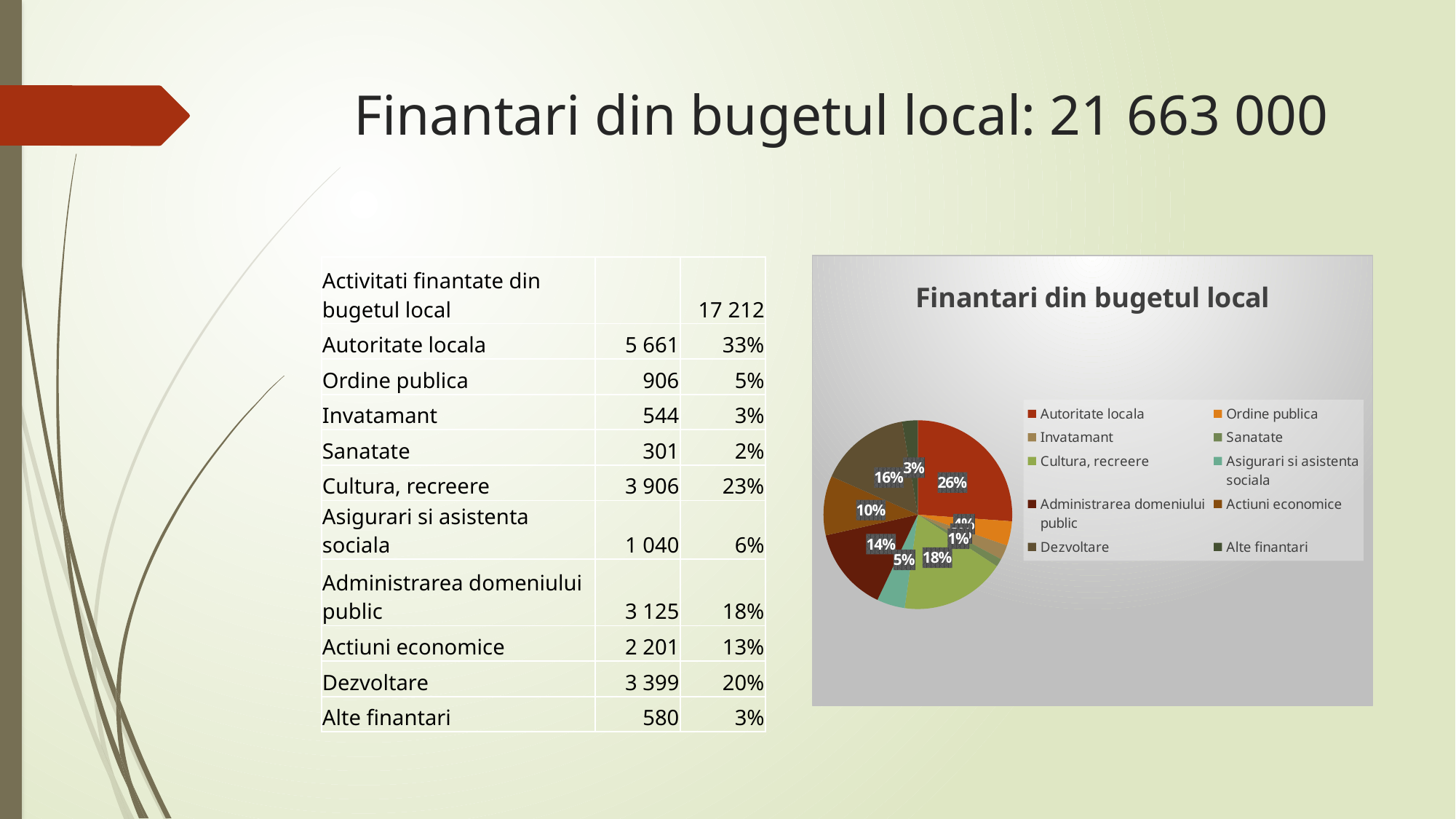
What share of the pie does Actiuni economice have? 10% What share of the pie does Cultura, recreere have? 18% Which category has the largest slice of the pie? Autoritate locala What is the title of the chart? Finantari din bugetul local What kind of chart is shown on the slide? pie chart What share of the pie does Administrarea domeniului public have? 14% Which slice is larger, Dezvoltare or Administrarea domeniului public? Dezvoltare How many categories does the chart's legend list? 10 By how many percentage points does the Autoritate locala slice exceed the Cultura, recreere slice? 8%